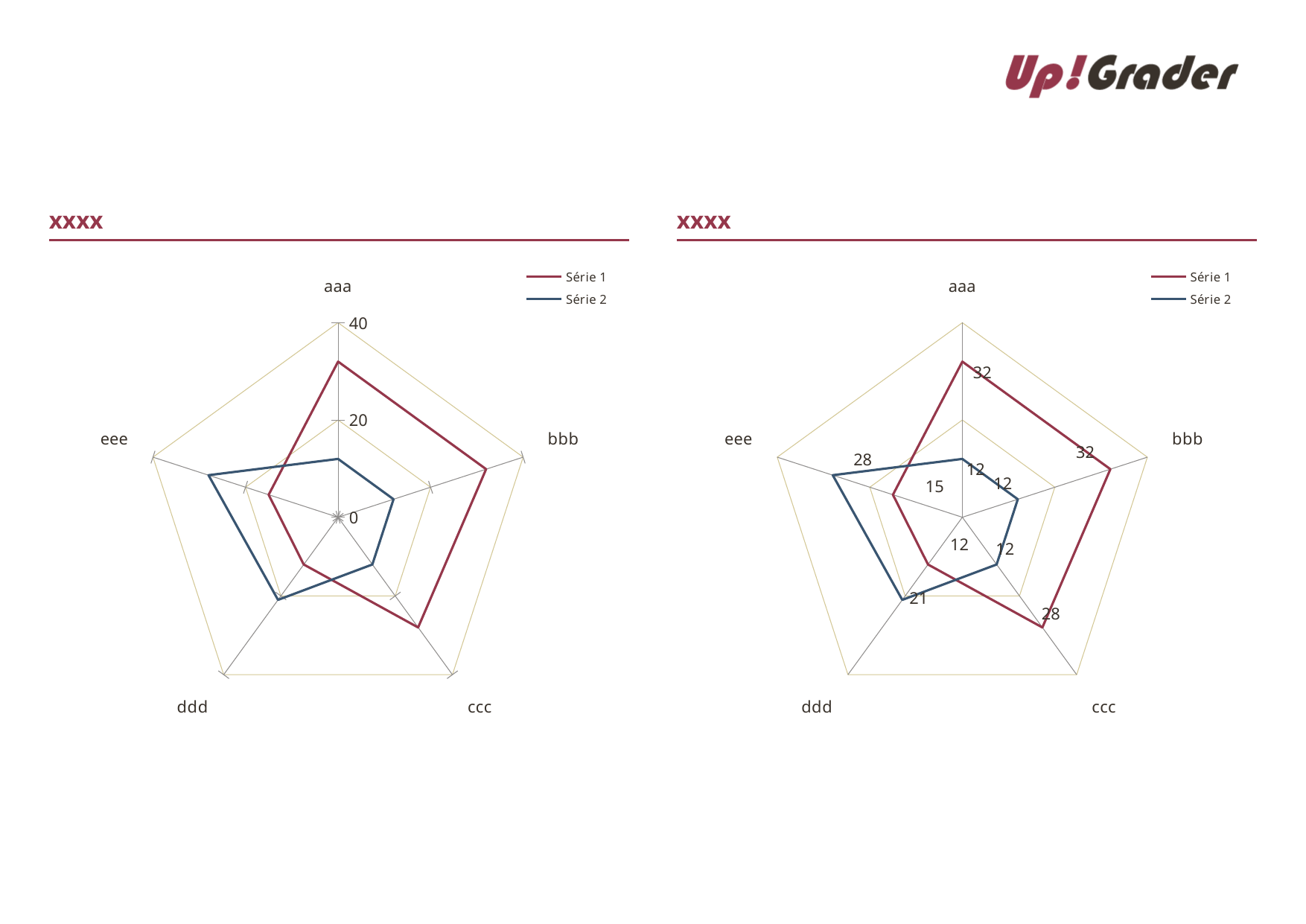
In the left chart, is the value of Série 1 for aaa greater or less than 20? greater In the right chart, which category has the highest value for Série 2? eee What kind of chart is the chart on the left of the slide? radar chart How many categories (axes) does the left radar chart have? 5 How many series does the legend of the right chart list? 2 In the right chart, what is the value of Série 2 for ddd? 21 In the right chart, what is the difference between Série 1 and Série 2 for bbb? 20 In the right chart, which category has the lowest value for Série 1? ddd In the right chart, what is the value of Série 1 for ccc? 28 In the right chart, what is the value of Série 2 for eee? 28 In the right chart, which series has the larger value for ddd, Série 1 or Série 2? Série 2 In the right chart, what is the value of Série 1 for aaa? 32